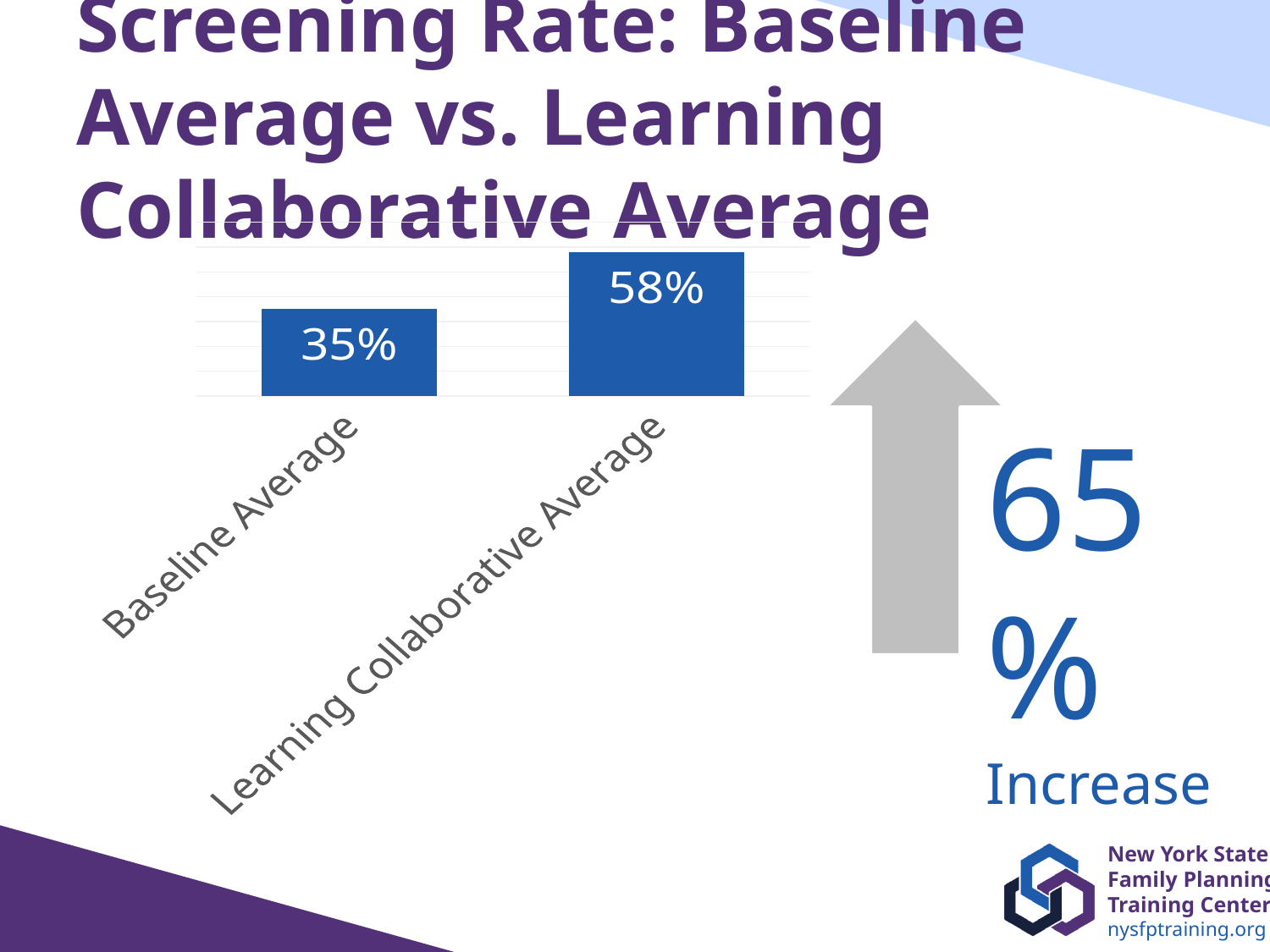
What kind of chart is shown on the slide? Bar chart What is the value for Learning Collaborative Average? 58% What is the difference between the Learning Collaborative Average and the Baseline Average? 23% How many categories are shown in the chart? 2 What is the value for Baseline Average? 35% What percentage increase is stated next to the arrow beside the chart? 65% What is the title of the slide containing the chart? Screening Rate: Baseline Average vs. Learning Collaborative Average Do the values rise or fall from Baseline Average to Learning Collaborative Average? Rise Which category has the highest value? Learning Collaborative Average Which category has the lowest value? Baseline Average Which is larger, the Baseline Average or the Learning Collaborative Average? Learning Collaborative Average